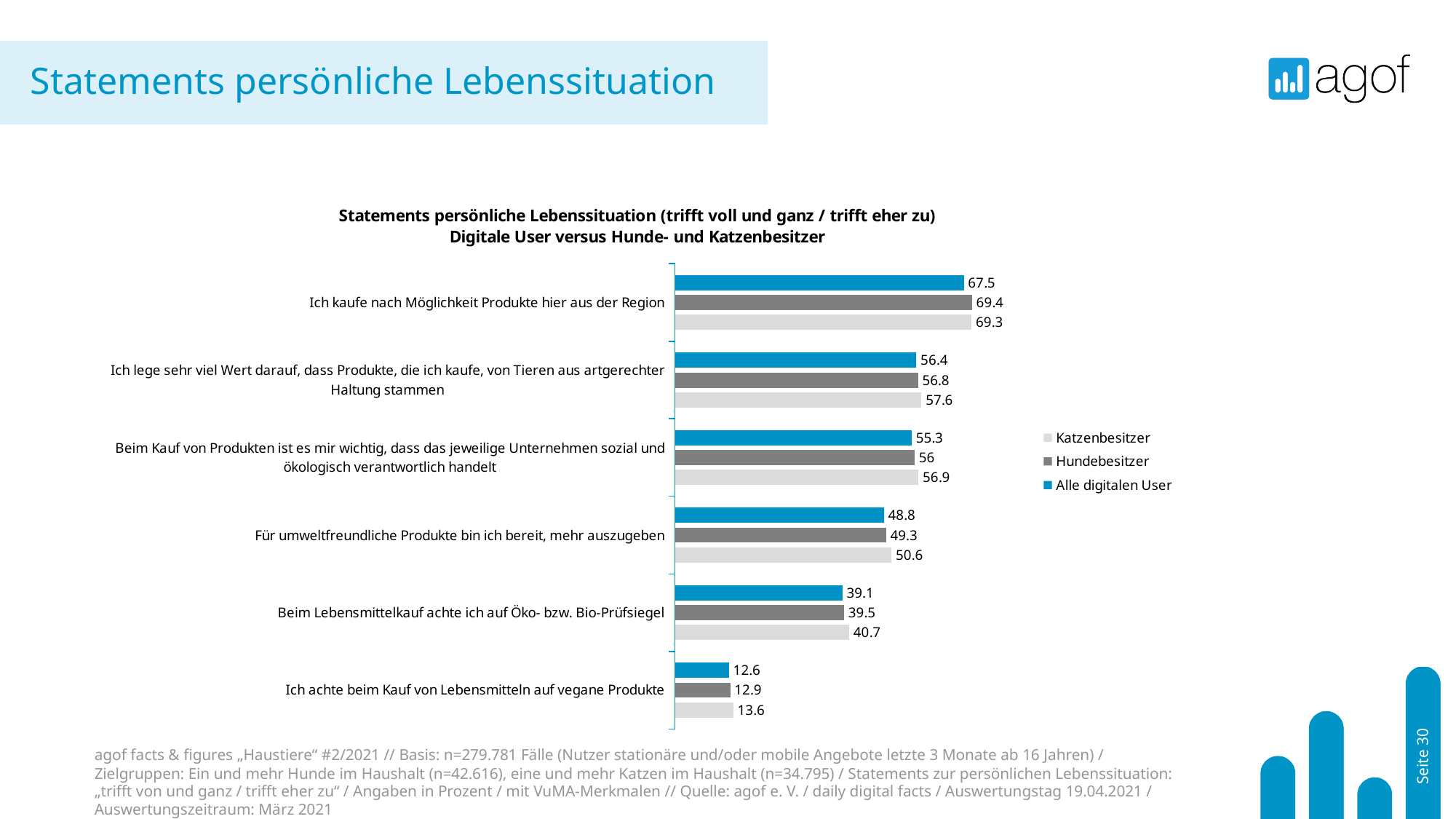
What is the difference between the Katzenbesitzer and Alle digitalen User values for "Ich lege sehr viel Wert darauf, dass Produkte, die ich kaufe, von Tieren aus artgerechter Haltung stammen"? 1.2 Which series is shown in blue in the chart? Alle digitalen User What is the value for Hundebesitzer for the statement "Für umweltfreundliche Produkte bin ich bereit, mehr auszugeben"? 49.3 What is the value for Alle digitalen User for the statement "Ich kaufe nach Möglichkeit Produkte hier aus der Region"? 67.5 What is the value for Hundebesitzer for the statement "Beim Kauf von Produkten ist es mir wichtig, dass das jeweilige Unternehmen sozial und ökologisch verantwortlich handelt"? 56 For the statement "Ich achte beim Kauf von Lebensmitteln auf vegane Produkte", which is larger: the value for Hundebesitzer or for Katzenbesitzer? Katzenbesitzer What is the value for Katzenbesitzer for the statement "Beim Lebensmittelkauf achte ich auf Öko- bzw. Bio-Prüfsiegel"? 40.7 How many statements (categories) are shown in the chart? 6 How many series does the legend list? 3 Which statement has the lowest value for Alle digitalen User? Ich achte beim Kauf von Lebensmitteln auf vegane Produkte What kind of chart is shown on the slide? bar chart Which statement has the highest value for Katzenbesitzer? Ich kaufe nach Möglichkeit Produkte hier aus der Region